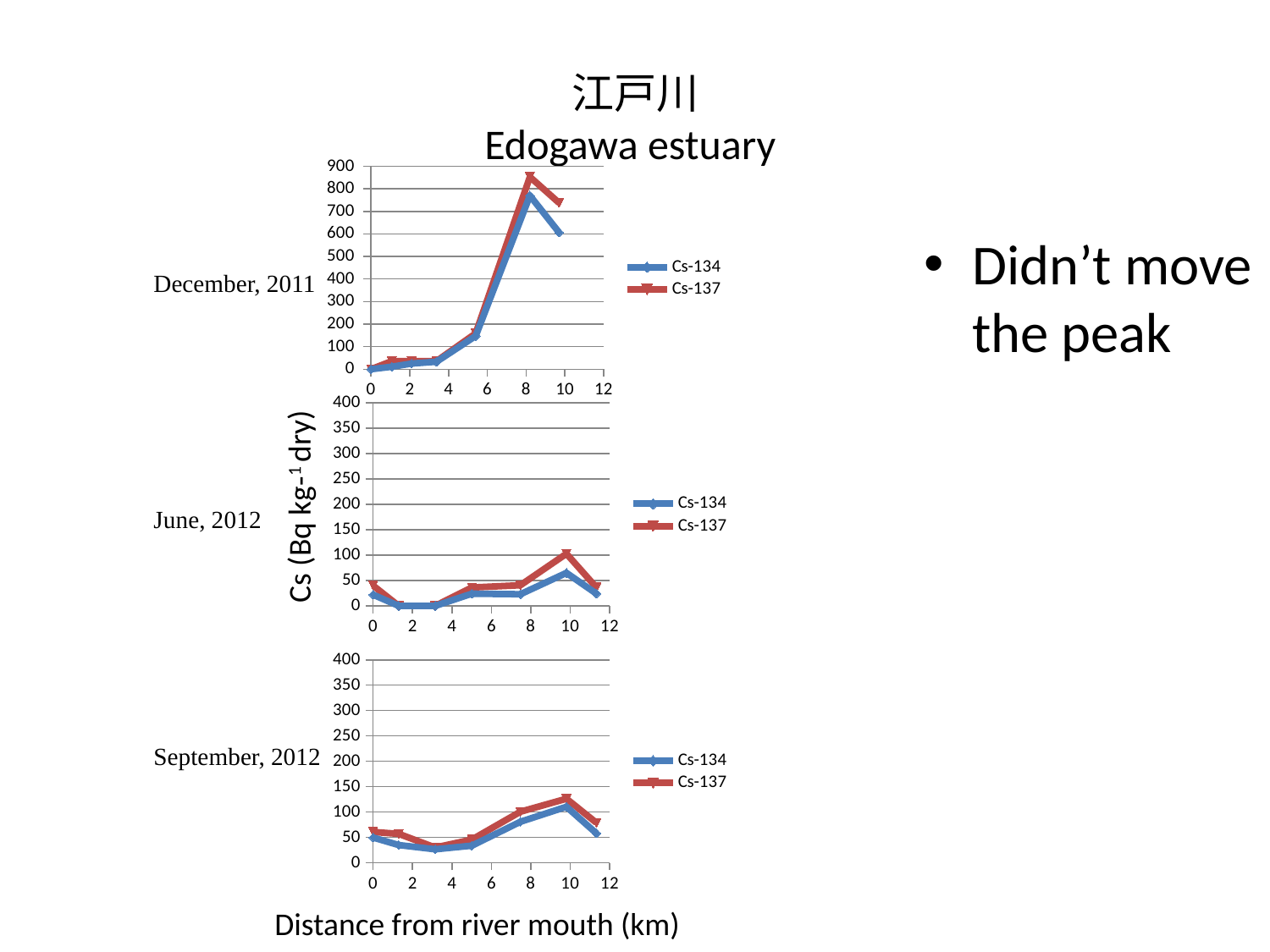
In the December, 2011 chart, do the Cs-137 values rise or fall between 4 km and 8 km? rise In the September, 2012 chart, is the highest value of Cs-137 greater or less than 100? greater In the September, 2012 chart, is the highest value of Cs-134 greater or less than 150? less In the December, 2011 chart, is the peak value of Cs-137 greater or less than 800? greater How many series does the legend of the June, 2012 chart list? 2 In the December, 2011 chart, which series reaches the higher peak, Cs-134 or Cs-137? Cs-137 What is the highest value shown on the y axis of the December, 2011 chart? 900 What kind of chart is the December, 2011 chart? line chart What are the two series named in the legend of the September, 2012 chart? Cs-134 and Cs-137 What is the label of the shared x axis below the charts? Distance from river mouth (km)